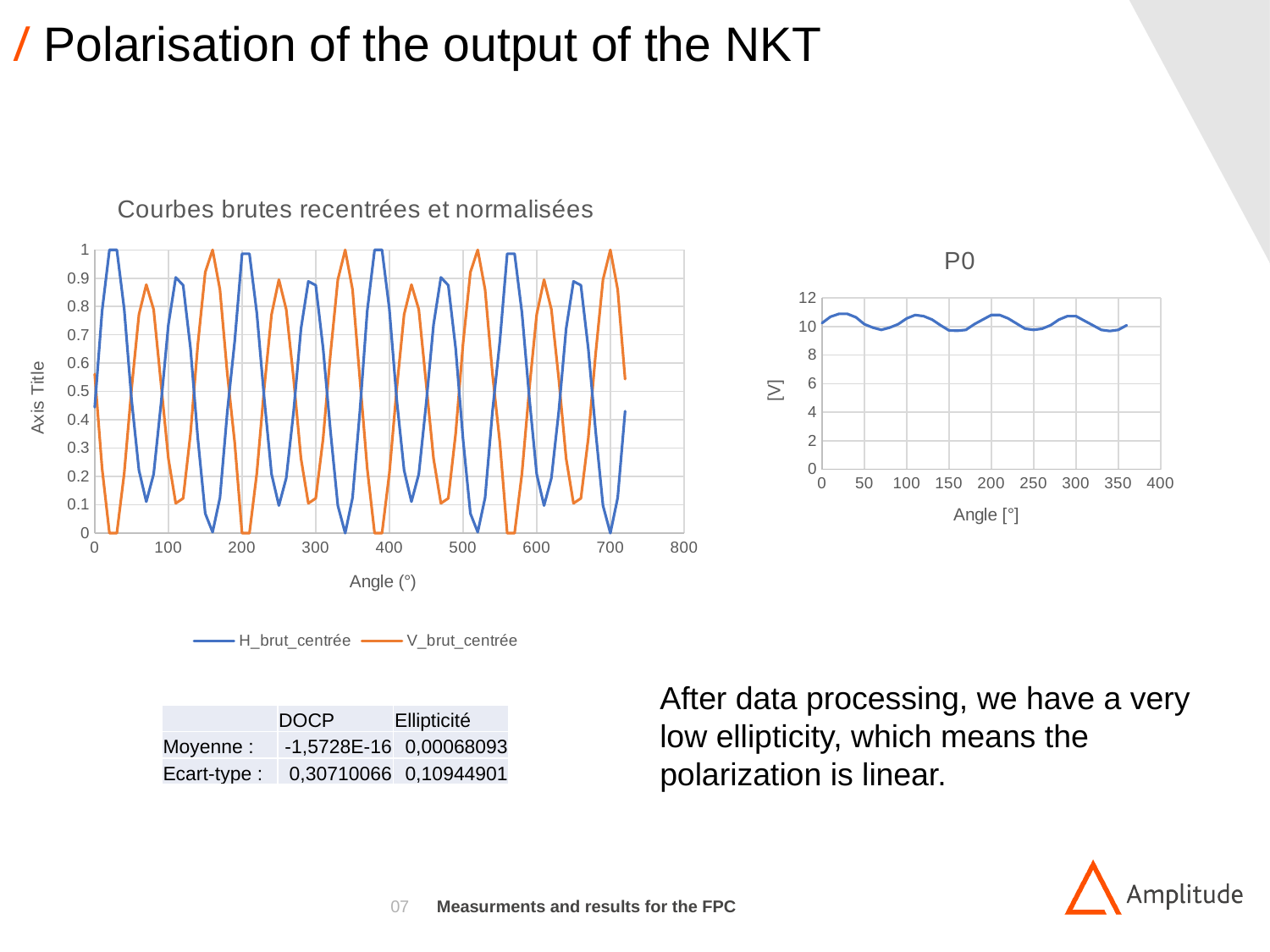
In the chart "Courbes brutes recentrées et normalisées", what is the lowest value reached by the V_brut_centrée series? 0 In the chart "P0", does the value show a strong overall rise, a strong overall fall, or stay roughly flat across the angle range? roughly flat In the chart "Courbes brutes recentrées et normalisées", what are the two series named in the legend? H_brut_centrée and V_brut_centrée In the chart "P0", is the value at an angle of 200° greater or less than 12? less In the chart "Courbes brutes recentrées et normalisées", what is the highest value reached by the V_brut_centrée series? 1 What kind of chart is the chart titled "Courbes brutes recentrées et normalisées"? line chart What kind of chart is the chart titled "P0"? line chart How many series does the legend of the chart "Courbes brutes recentrées et normalisées" list? 2 In the chart "P0", what unit is shown on the y axis? [V] In the chart "P0", is the value at an angle of 100° greater or less than 8? greater In the chart "Courbes brutes recentrées et normalisées", what is the label of the x axis? Angle (°)